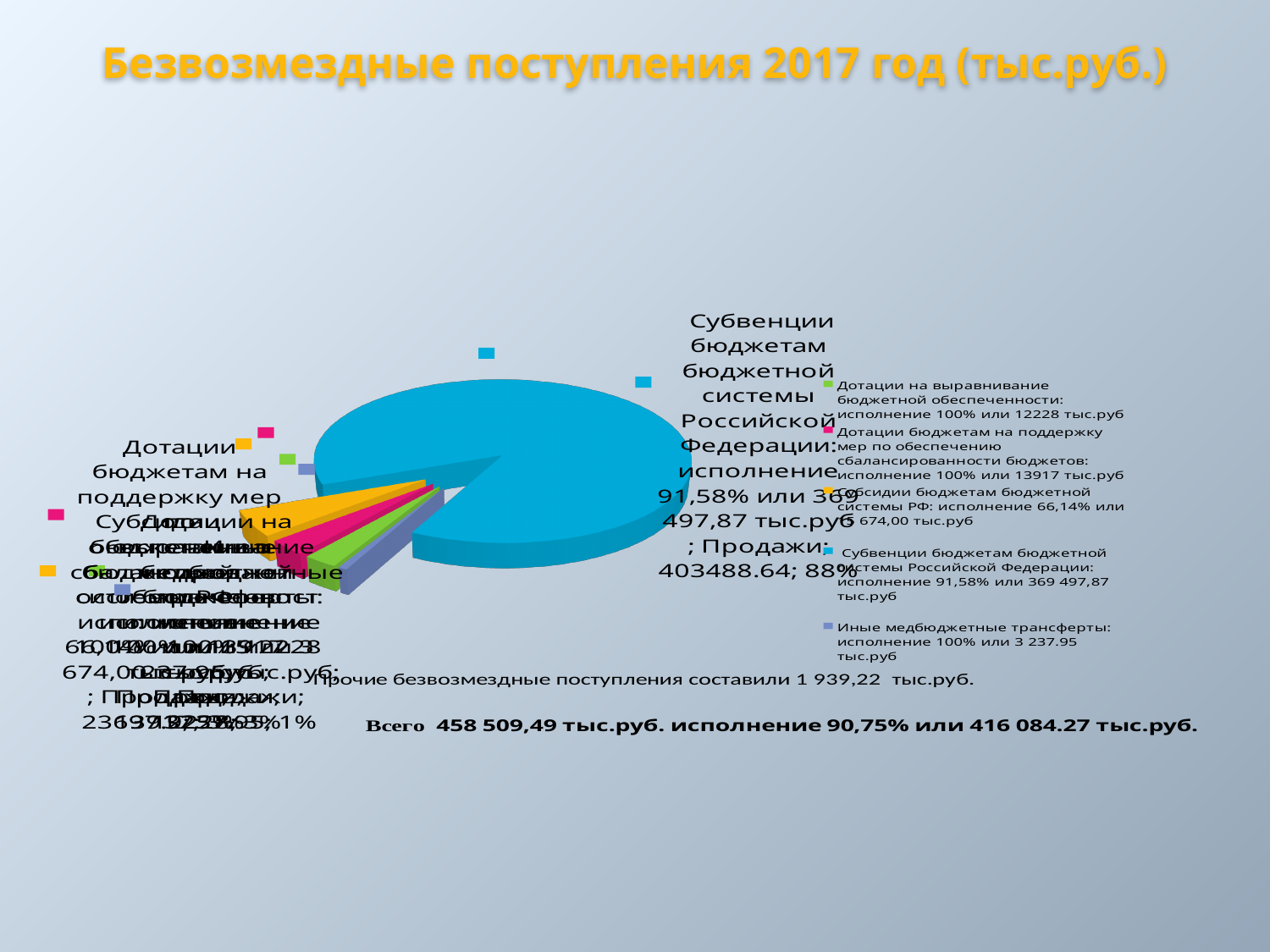
How many entries does the chart's legend list? 5 Is the share of the Субвенции бюджетам бюджетной системы Российской Федерации slice greater or less than 50%? greater What kind of chart is shown on the slide? pie chart What share of the pie does the slice for Субвенции бюджетам бюджетной системы Российской Федерации represent, according to its data label? 88% Which category has the largest slice of the pie? Субвенции бюджетам бюджетной системы Российской Федерации What is the title of the chart on the slide? Безвозмездные поступления 2017 год (тыс.руб.) What value is printed in the data label for the Субвенции бюджетам бюджетной системы Российской Федерации slice? 403488.64 What colour is the largest slice of the pie? blue